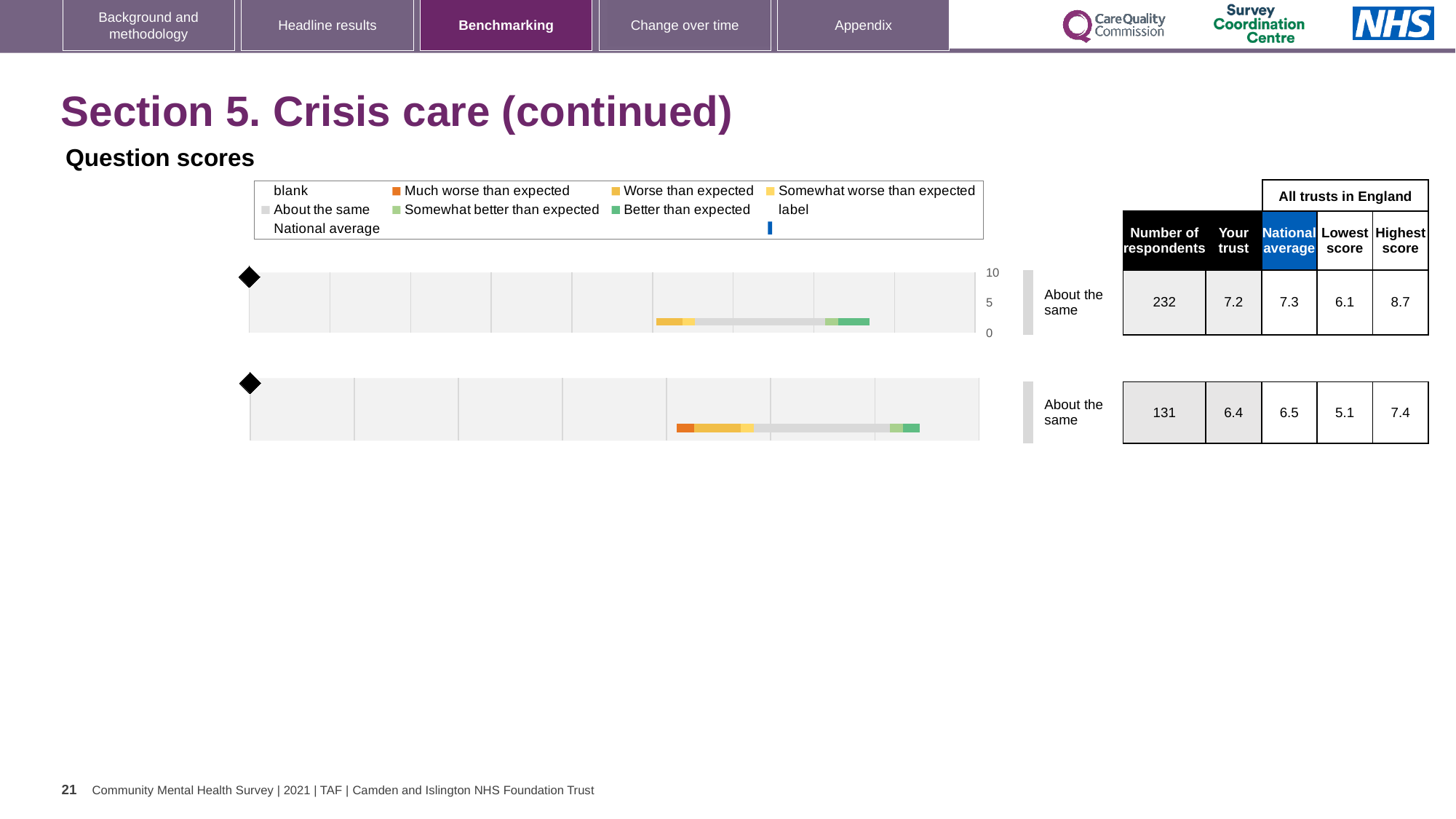
What benchmark category label is shown next to both charts? About the same For the top chart, which is larger: the 'Your trust' score or the national average? National average For the top chart, what is the difference between the highest score (8.7) and the lowest score (6.1)? 2.6 In the legend, what colour represents 'Much worse than expected'? Orange Which chart has the higher lowest score: the top chart or the bottom chart? Top chart For the top chart, what is the national average score shown in the table? 7.3 How many benchmarking charts are shown on the slide? 2 For the top chart, what is the 'Your trust' score shown in the table? 7.2 For the bottom chart, what is the highest score among all trusts in England? 7.4 For the bottom chart, how many respondents are shown in the table? 131 What kind of chart is the top chart on the slide? bar chart For the bottom chart, what is the difference between the highest score (7.4) and the lowest score (5.1)? 2.3